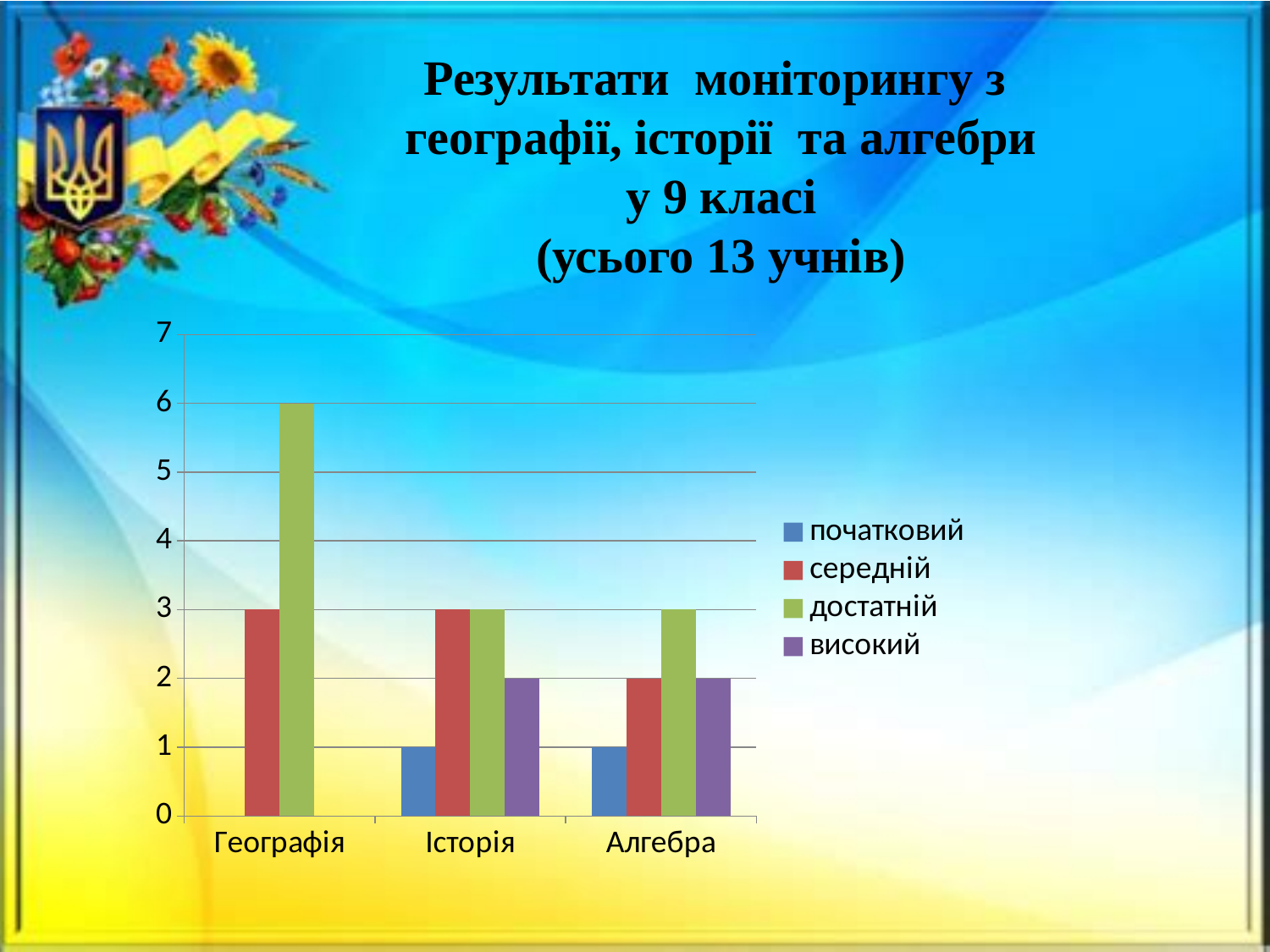
How many series does the legend list? 4 What is the value for високий in Історія? 2 What is the value for середній in Географія? 3 How many categories are shown on the x axis? 3 Which legend entry is shown in green? достатній Which is larger: середній in Історія or середній in Алгебра? середній in Історія What is the value for початковий in Алгебра? 1 What kind of chart is shown on the slide? bar chart What is the value for достатній in Географія? 6 Which category has the highest value for достатній? Географія What is the difference between достатній in Географія and достатній in Історія? 3 What is the value for середній in Алгебра? 2